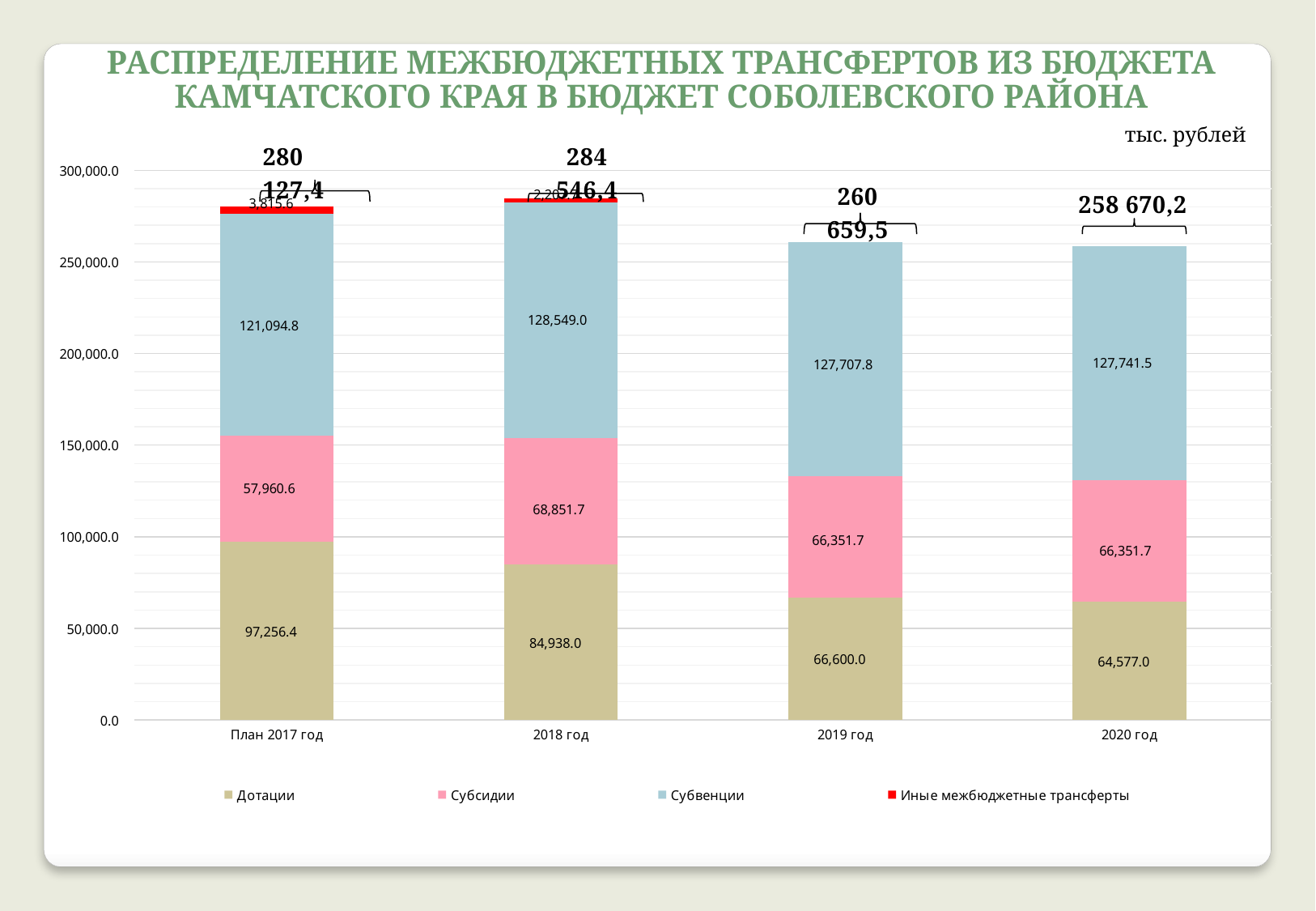
How many categories (years) are shown on the x axis? 4 What is the difference between Дотации for План 2017 год and Дотации for 2018 год? 12,318.4 What is the total shown above the bar for 2020 год? 258 670,2 What type of chart is shown on the slide? stacked bar chart How many series does the legend list? 4 What is the value of Дотации for 2020 год? 64,577.0 What is the value of Субсидии for 2019 год? 66,351.7 Which year has the lowest value of Субсидии? План 2017 год What is the value of Субвенции for 2018 год? 128,549.0 Which is larger: Субвенции for 2019 год or Субвенции for 2020 год? Субвенции for 2020 год Which year has the highest value of Дотации? План 2017 год What is the value of Дотации for План 2017 год? 97,256.4